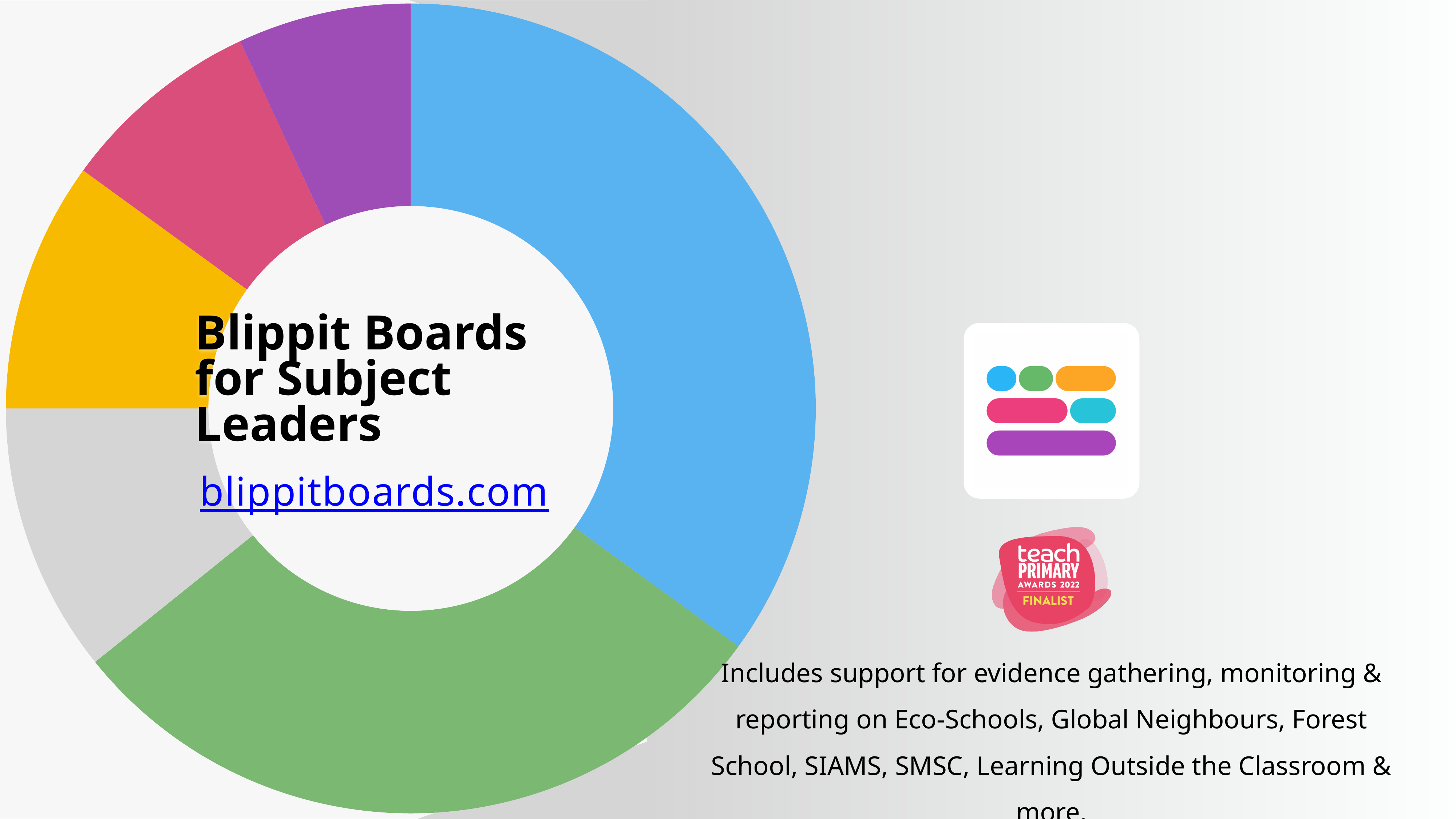
What kind of chart is shown on the slide? Doughnut (pie) chart Which is larger in the doughnut chart, the blue segment or the green segment? Blue How many segments does the doughnut chart have? 6 Does the doughnut chart show a legend with category labels? No Which is larger in the doughnut chart, the green segment or the yellow segment? Green Which colour segment of the doughnut chart is the largest? Blue What text appears in the centre of the doughnut chart? Blippit Boards for Subject Leaders, with the link blippitboards.com